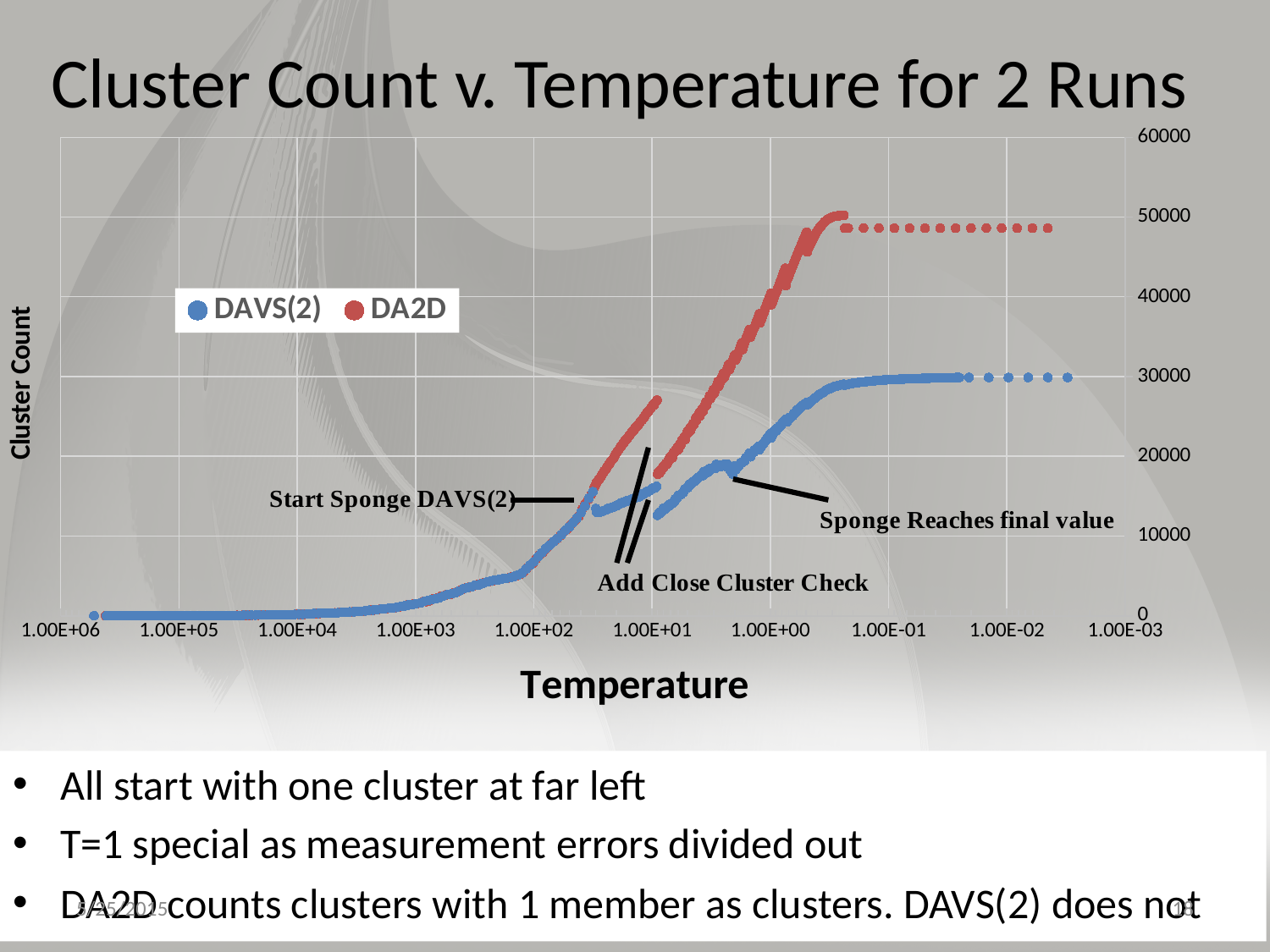
How many series does the chart legend list? 2 Is the final cluster count for DAVS(2) at the right end of the chart greater or less than 40000? less What are the names of the two series in the legend? DAVS(2) and DA2D Which series has the higher cluster count at a temperature of 1.00E+00, DAVS(2) or DA2D? DA2D Is the final cluster count for DA2D at the right end of the chart greater or less than 50000? less What kind of chart is shown on the slide? scatter chart Does the cluster count for DAVS(2) generally rise or fall moving from left to right along the x axis? rise What is the maximum value shown on the vertical axis? 60000 Is the final cluster count for DA2D at the right end of the chart greater or less than 40000? greater What is the title of the chart? Cluster Count v. Temperature for 2 Runs Which series reaches the higher final cluster count at the right end of the chart, DAVS(2) or DA2D? DA2D